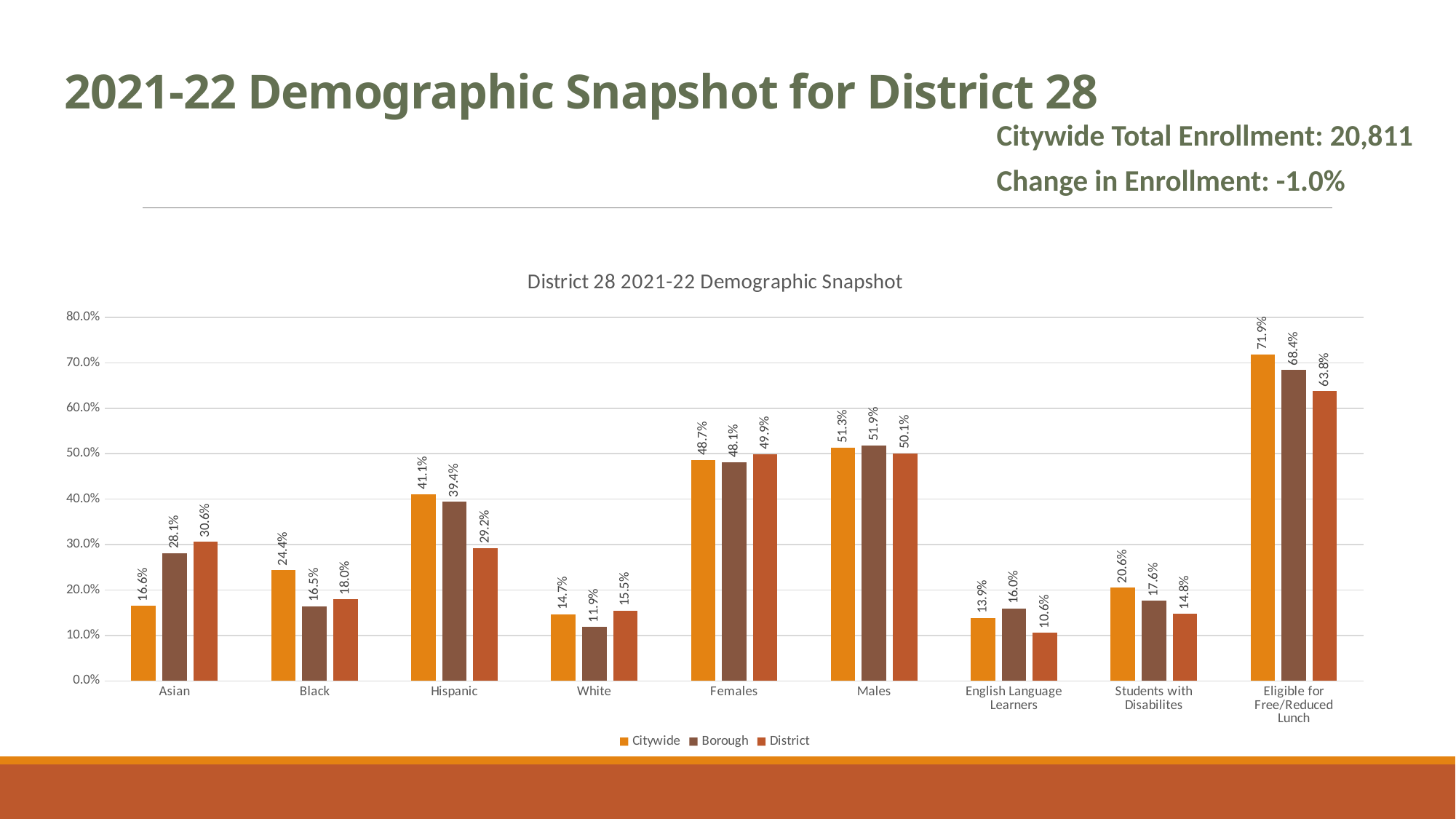
Which is larger for Black: the Citywide value or the District value? Citywide What kind of chart is shown on the slide? Bar chart How many categories are shown on the x axis? 9 Which category has the lowest Borough value? White How many series does the legend list? 3 What is the difference between the Citywide and District values for Eligible for Free/Reduced Lunch? 8.1% What is the title of the chart? District 28 2021-22 Demographic Snapshot What is the Citywide value for Hispanic? 41.1% What is the Borough value for Students with Disabilites? 17.6% Which category has the highest District value? Eligible for Free/Reduced Lunch Is the Borough value for Hispanic greater or less than 30.0%? greater What is the District value for Asian? 30.6%